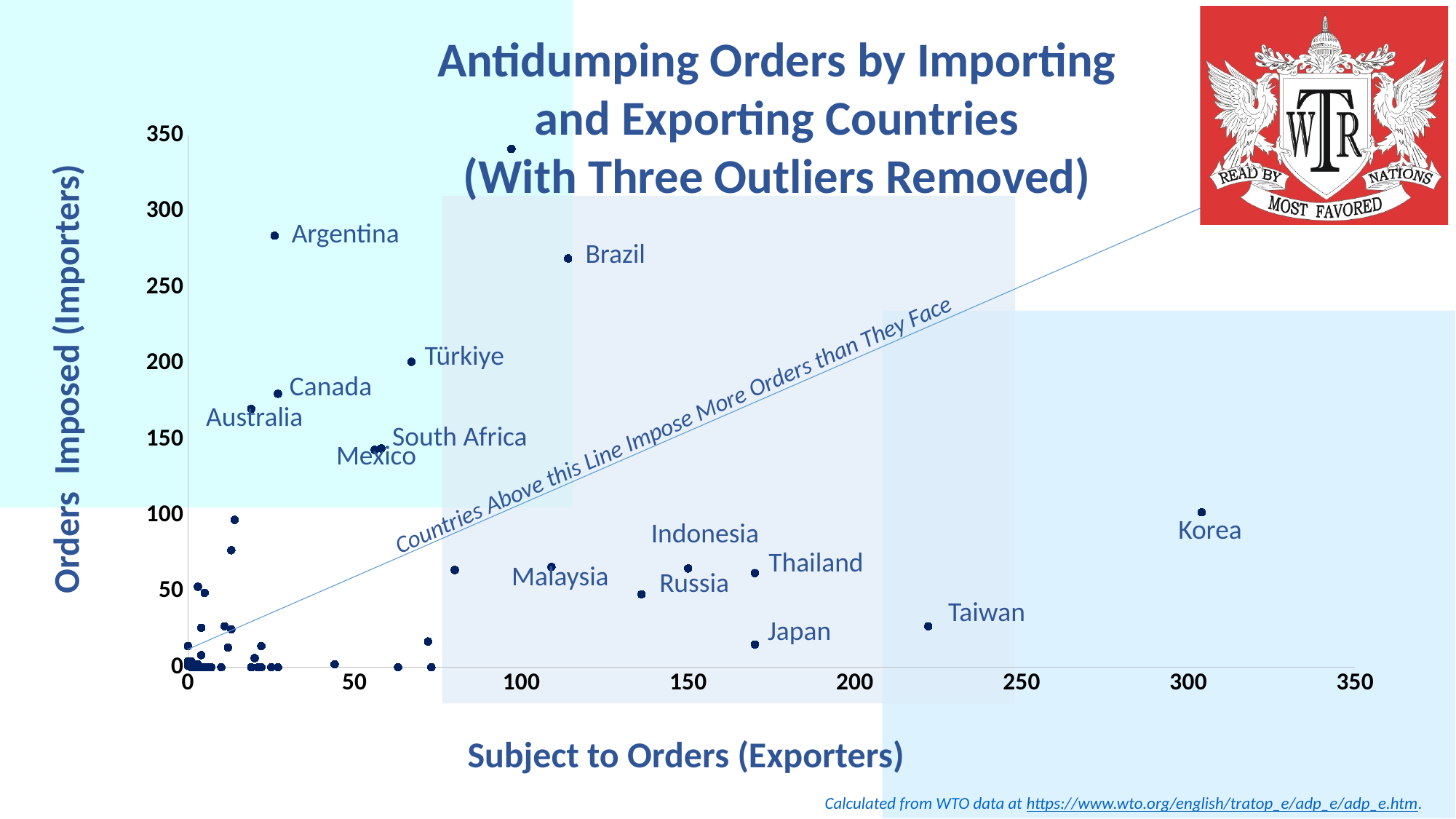
Is the Subject to Orders value for Taiwan greater or less than 200? greater What is the title of the chart? Antidumping Orders by Importing and Exporting Countries (With Three Outliers Removed) Is the Subject to Orders value for Brazil greater or less than 100? greater What kind of chart is shown on the slide? Scatter chart Is the Orders Imposed value for Argentina greater or less than 250? greater Among the labelled countries, which has the highest Subject to Orders (Exporters) value? Korea What is the label of the vertical axis? Orders Imposed (Importers) Among the labelled countries, which has the lowest Orders Imposed (Importers) value? Japan Which has the higher Orders Imposed value, Thailand or Japan? Thailand